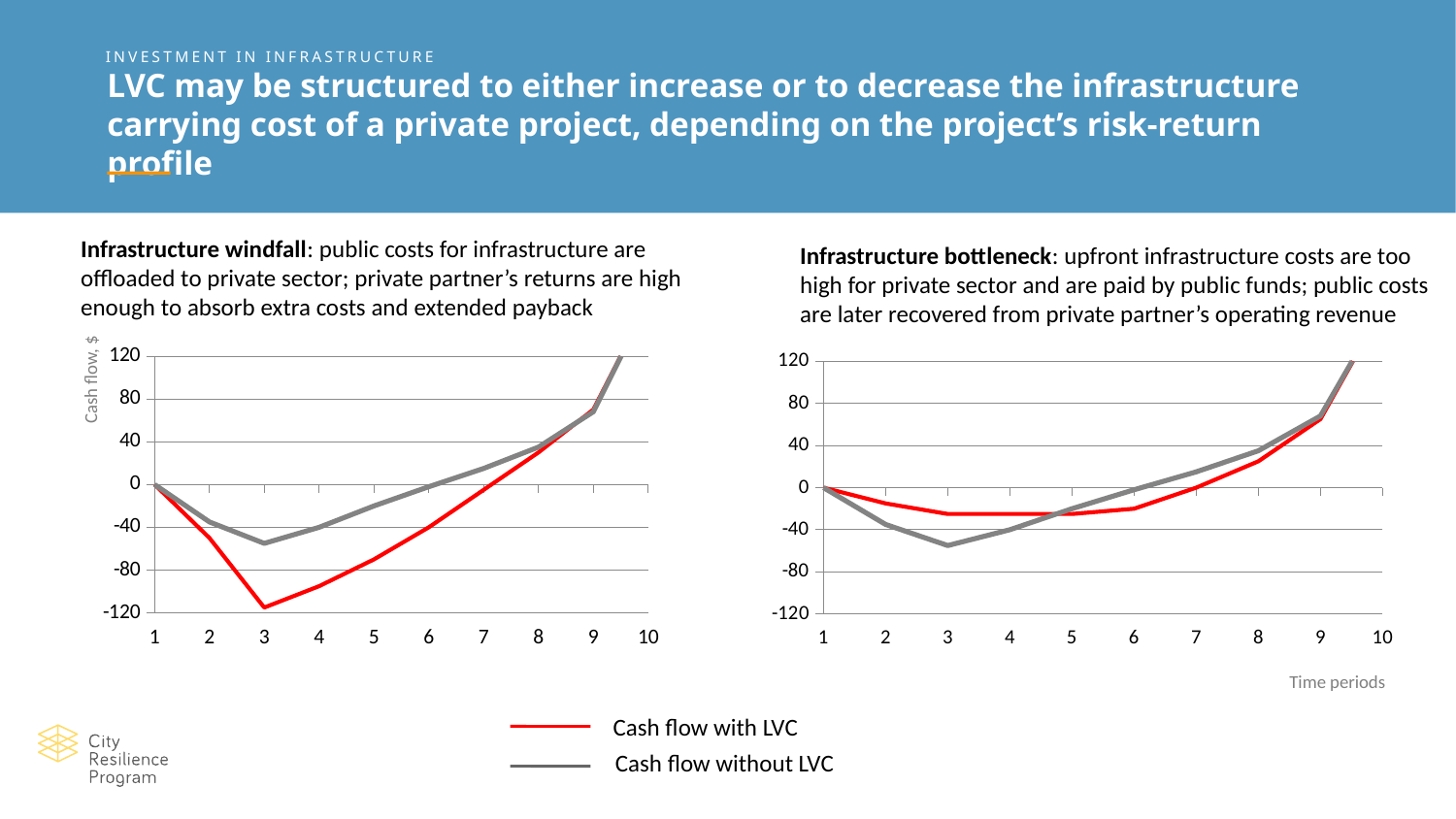
In the Infrastructure bottleneck chart on the right, which line is lower at period 3: Cash flow with LVC or Cash flow without LVC? Cash flow without LVC In the Infrastructure windfall chart on the left, which line is lower at period 3: Cash flow with LVC or Cash flow without LVC? Cash flow with LVC In the Infrastructure bottleneck chart on the right, at which time period does the Cash flow without LVC line reach its lowest value? 3 In the Infrastructure bottleneck chart on the right, is the Cash flow with LVC value at period 3 greater or less than -40? greater What kind of chart is the Infrastructure windfall chart on the left? line chart In the Infrastructure windfall chart on the left, at which time period does the Cash flow with LVC line reach its lowest value? 3 How many time periods are shown on the x axis of the Infrastructure bottleneck chart on the right? 10 What is the label on the y axis of the Infrastructure windfall chart on the left? Cash flow, $ In the Infrastructure windfall chart on the left, is the Cash flow with LVC value at period 3 greater or less than -80? less How many series does the legend list for the charts? 2 In the Infrastructure windfall chart on the left, do the cash flow values rise or fall from period 3 to period 9? rise In the Infrastructure bottleneck chart on the right, is the Cash flow without LVC value at period 3 greater or less than -40? less